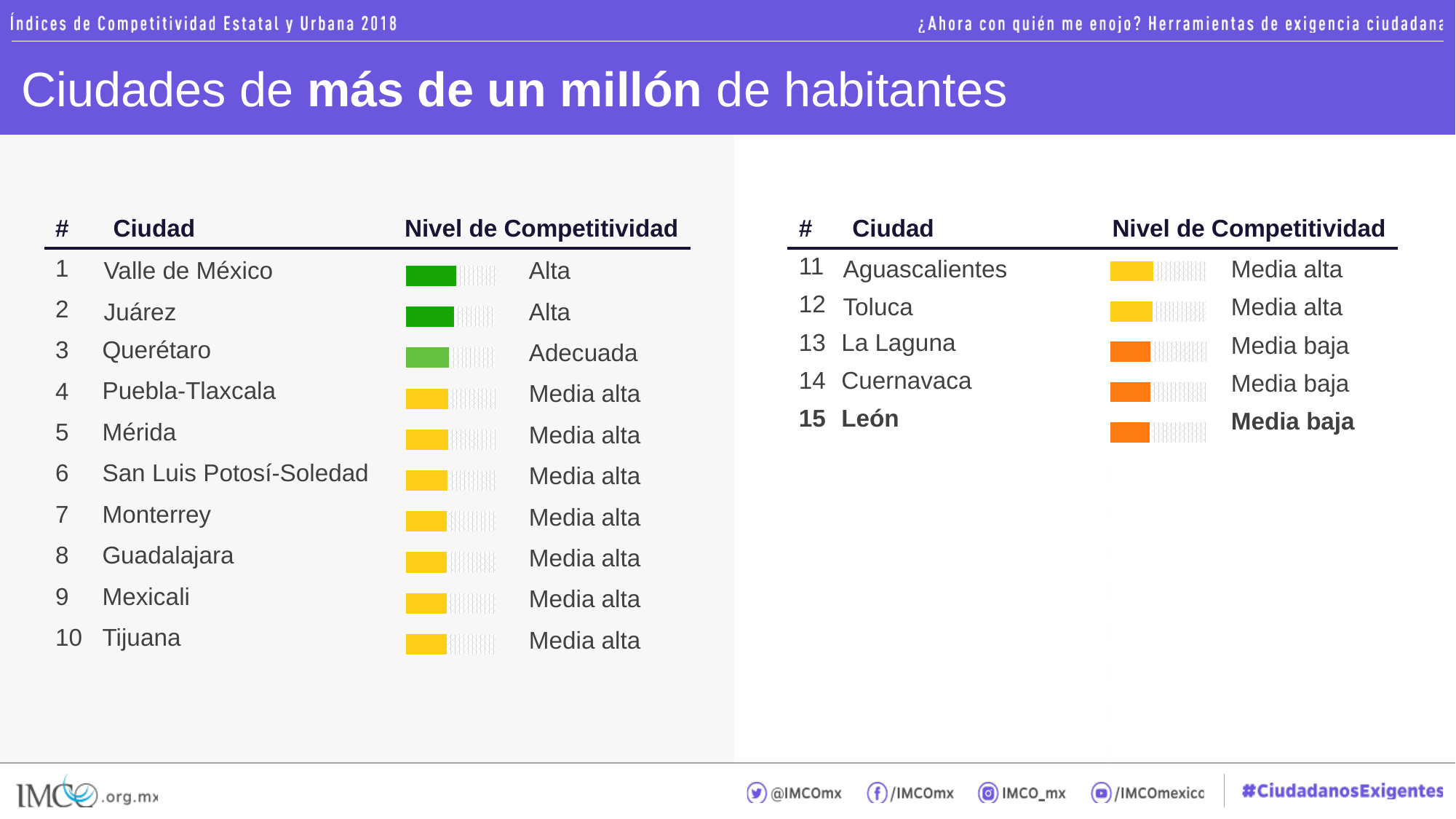
Which city holds the lowest rank (15) on the slide? León How many cities are listed across both tables on the slide? 15 What is the Nivel de Competitividad shown for Querétaro? Adecuada Which city is listed at rank 13? La Laguna How many cities are rated 'Alta'? 2 What colour are the bar indicators for cities rated 'Media alta'? Yellow What colour are the bar indicators for cities rated 'Media baja'? Orange What is the Nivel de Competitividad shown for León? Media baja Which is ranked higher in competitiveness, Juárez or Tijuana? Juárez How many cities are rated 'Media baja'? 3 What rank number is given to Monterrey? 7 Which city is ranked #1 in the table? Valle de México